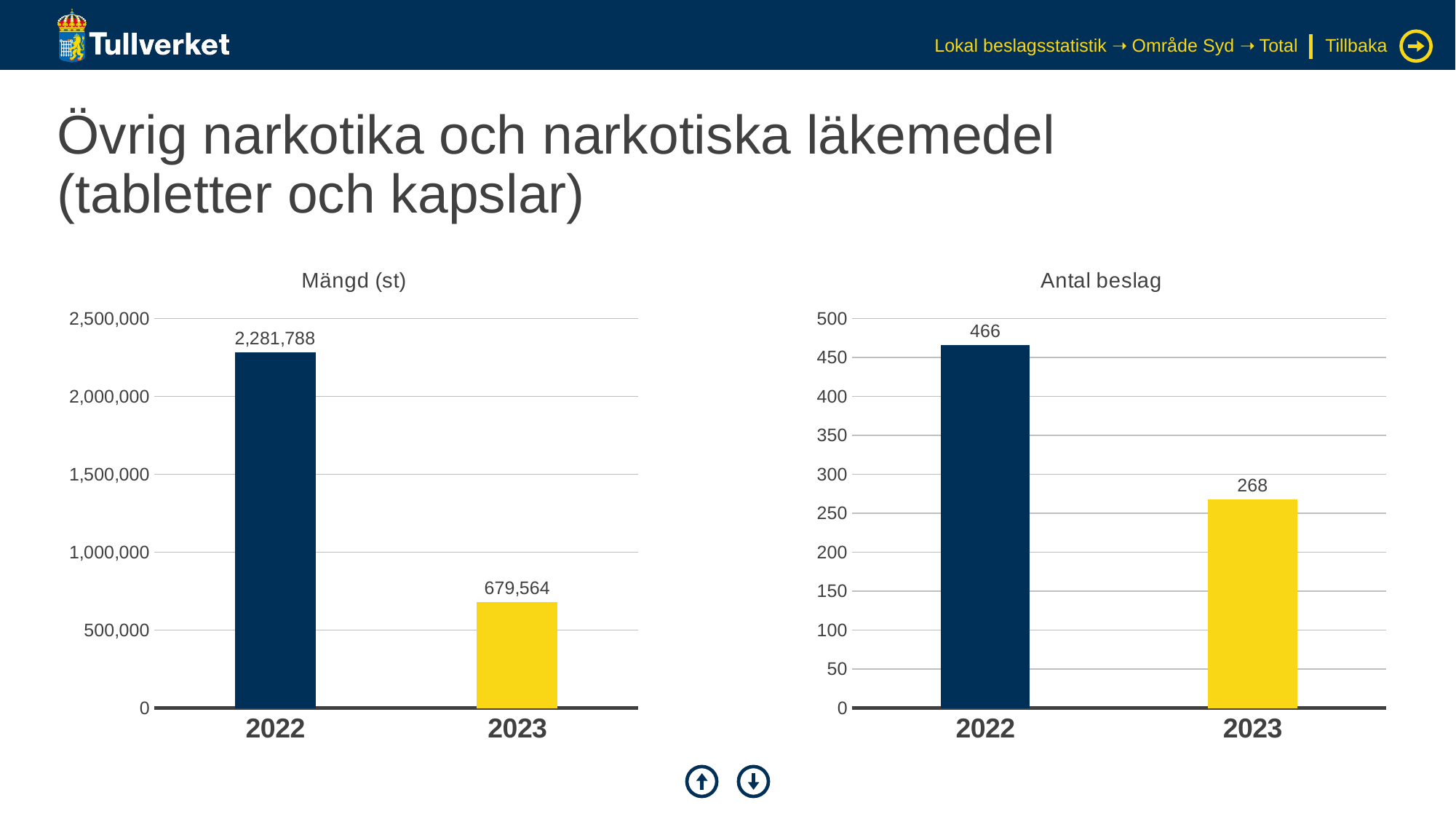
In the 'Antal beslag' chart, how many categories are shown on the x axis? 2 In the 'Antal beslag' chart, what is the difference between the 2022 and 2023 values? 198 In the 'Antal beslag' chart, which year has the lowest value? 2023 In the 'Mängd (st)' chart, do the values rise or fall from 2022 to 2023? fall In the 'Mängd (st)' chart, is the value for 2023 greater or less than 1,000,000? less In the 'Antal beslag' chart, what is the value for 2023? 268 In the 'Mängd (st)' chart, what is the value for 2023? 679,564 What kind of chart is the 'Antal beslag' chart? bar chart In the 'Mängd (st)' chart, what is the difference between the 2022 and 2023 values? 1,602,224 In the 'Mängd (st)' chart, which year has the highest value? 2022 In the 'Mängd (st)' chart, what is the value for 2022? 2,281,788 In the 'Antal beslag' chart, what is the value for 2022? 466